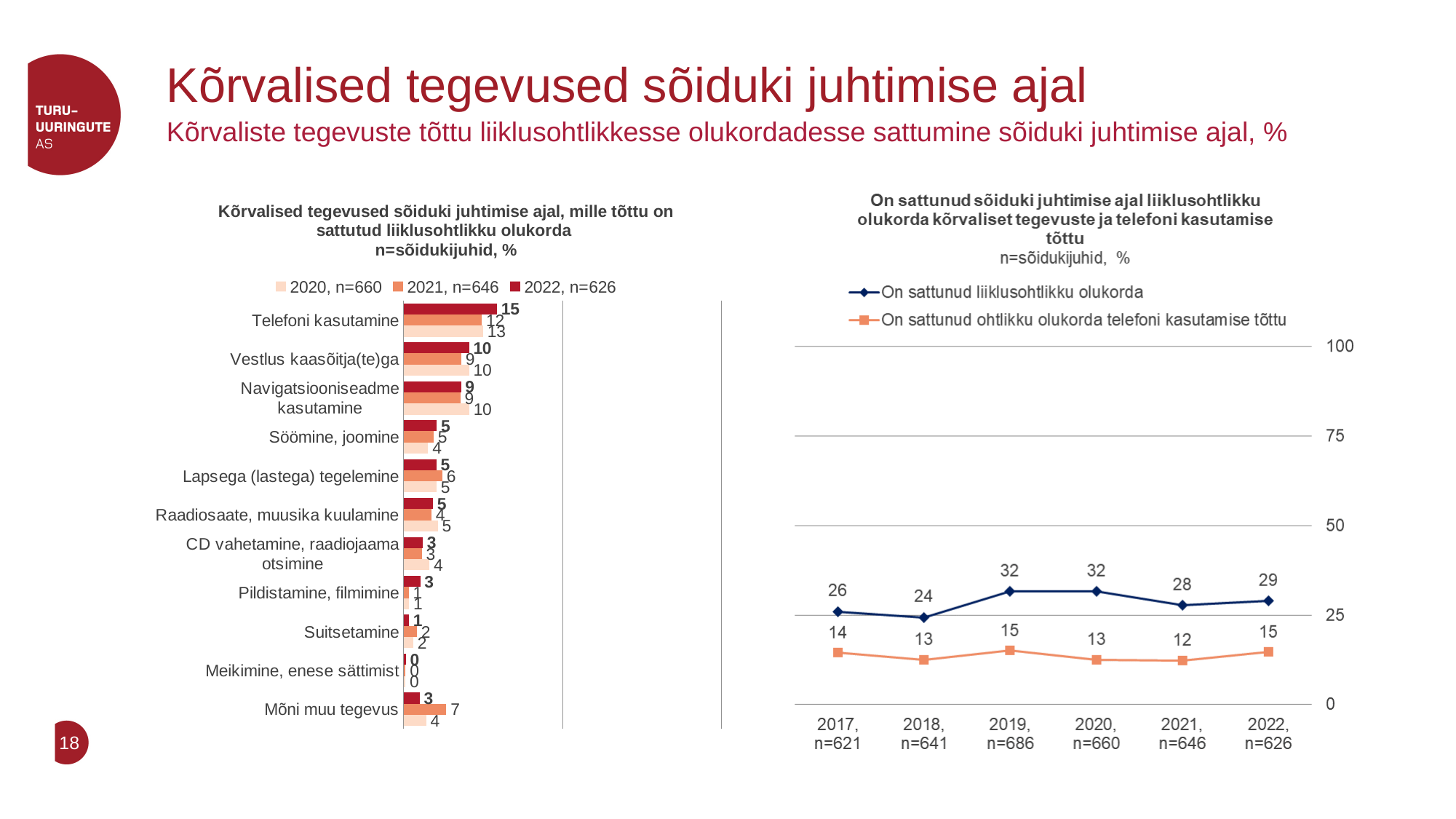
In the left bar chart, what is the difference between the 2022 and 2021 values for Telefoni kasutamine? 3 In the left bar chart, how many activity categories are shown? 11 In the left bar chart, what is the 2022 value for Telefoni kasutamine? 15 In the left bar chart, which activity has the highest 2022 value? Telefoni kasutamine In the right line chart, what is the difference between the two series in 2022? 14 In the right line chart, what is the value of 'On sattunud ohtlikku olukorda telefoni kasutamise tõttu' for 2021? 12 In the left bar chart, which activity has the lowest 2022 value? Meikimine, enese sättimist In the right line chart, what is the value of 'On sattunud liiklusohtlikku olukorda' for 2019? 32 What type of chart is shown on the right side of the slide? Line chart In the left bar chart, how many series does the legend list? 3 In the left bar chart, what is the 2021 value for Mõni muu tegevus? 7 In the right line chart, in which year is 'On sattunud liiklusohtlikku olukorda' lowest? 2018